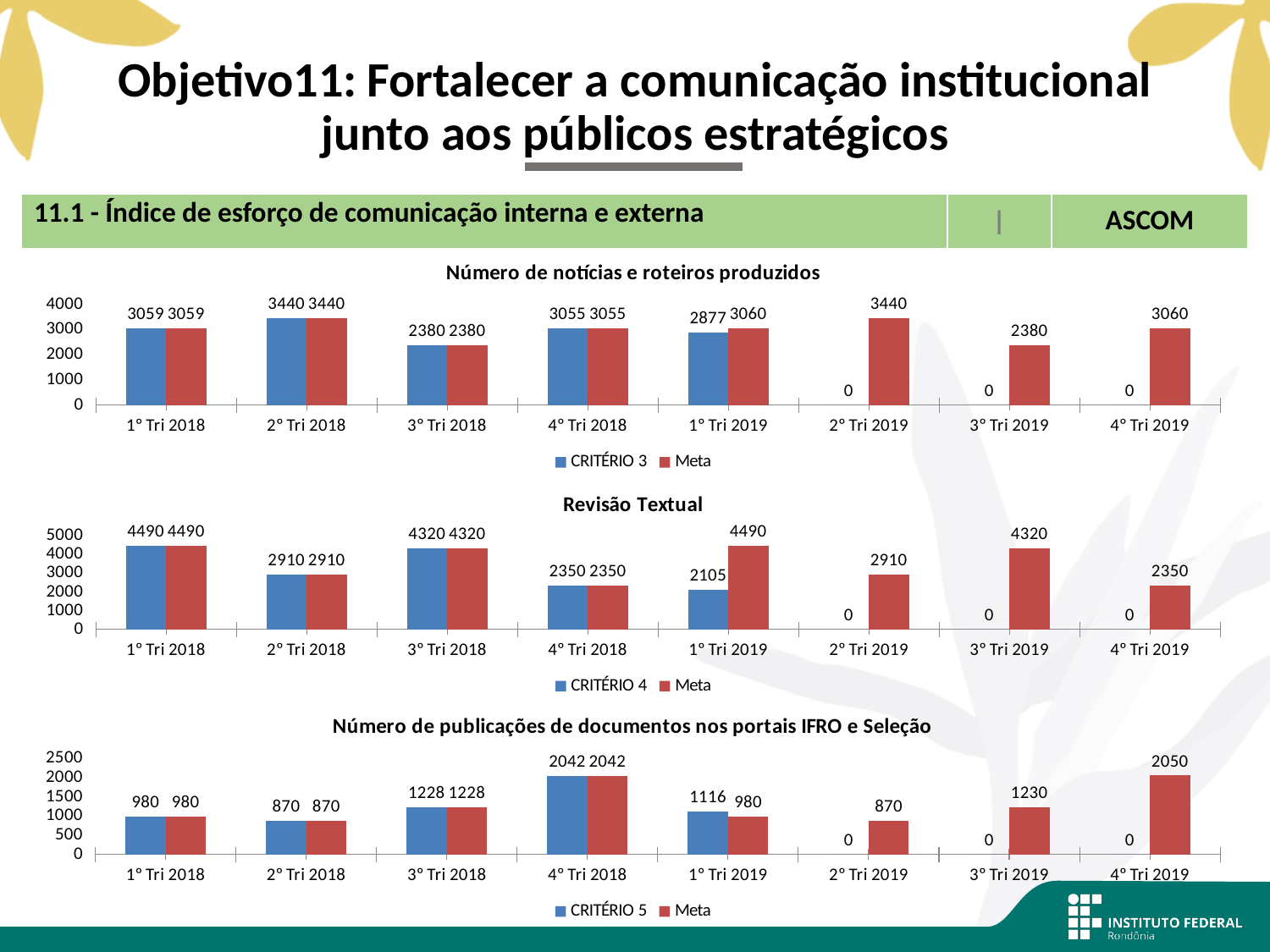
In the chart 'Número de publicações de documentos nos portais IFRO e Seleção', which is larger for 1° Tri 2019: CRITÉRIO 5 or Meta? CRITÉRIO 5 In the chart 'Revisão Textual', which is larger for 1° Tri 2019: CRITÉRIO 4 or Meta? Meta In the chart 'Número de publicações de documentos nos portais IFRO e Seleção', what is the difference between CRITÉRIO 5 and Meta for 1° Tri 2019? 136 In the chart 'Revisão Textual', which quarter has the highest Meta value? 1° Tri 2018 and 1° Tri 2019 (both 4490) In the chart 'Número de notícias e roteiros produzidos', what is the CRITÉRIO 3 value for 1° Tri 2019? 2877 How many series does the legend of the chart 'Número de notícias e roteiros produzidos' list? 2 In the chart 'Revisão Textual', what is the CRITÉRIO 4 value for 1° Tri 2019? 2105 What type of chart is 'Número de publicações de documentos nos portais IFRO e Seleção'? Bar chart How many quarters (categories) are shown on the x axis of the chart 'Revisão Textual'? 8 In the chart 'Número de notícias e roteiros produzidos', what is the Meta value for 2° Tri 2019? 3440 In the chart 'Número de notícias e roteiros produzidos', what is the difference between the Meta and CRITÉRIO 3 values for 1° Tri 2019? 183 In the chart 'Número de publicações de documentos nos portais IFRO e Seleção', what is the CRITÉRIO 5 value for 4° Tri 2018? 2042